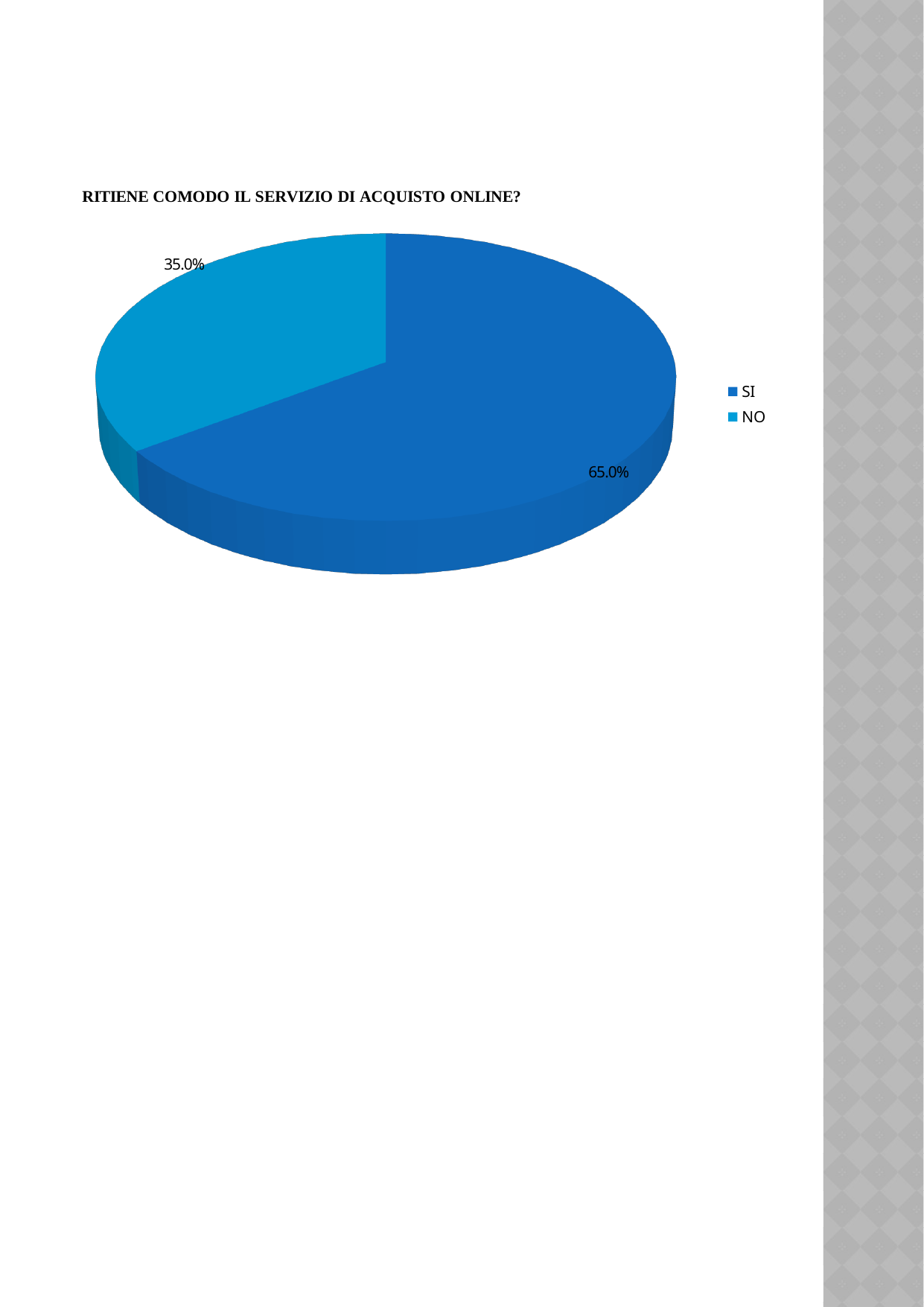
How many slices does the pie chart have? 2 Which category has the largest share of the pie? SI Which legend entry is listed first? SI What is the value for SI? 65.0% What share of the pie does the NO slice represent? 35.0% Which is larger, the value for SI or the value for NO? SI What kind of chart is shown on the slide? pie chart Which category has the smallest share of the pie? NO How many entries does the legend list? 2 What is the title of the chart? RITIENE COMODO IL SERVIZIO DI ACQUISTO ONLINE? What is the value for NO? 35.0% What is the difference between the SI and NO values? 30.0%